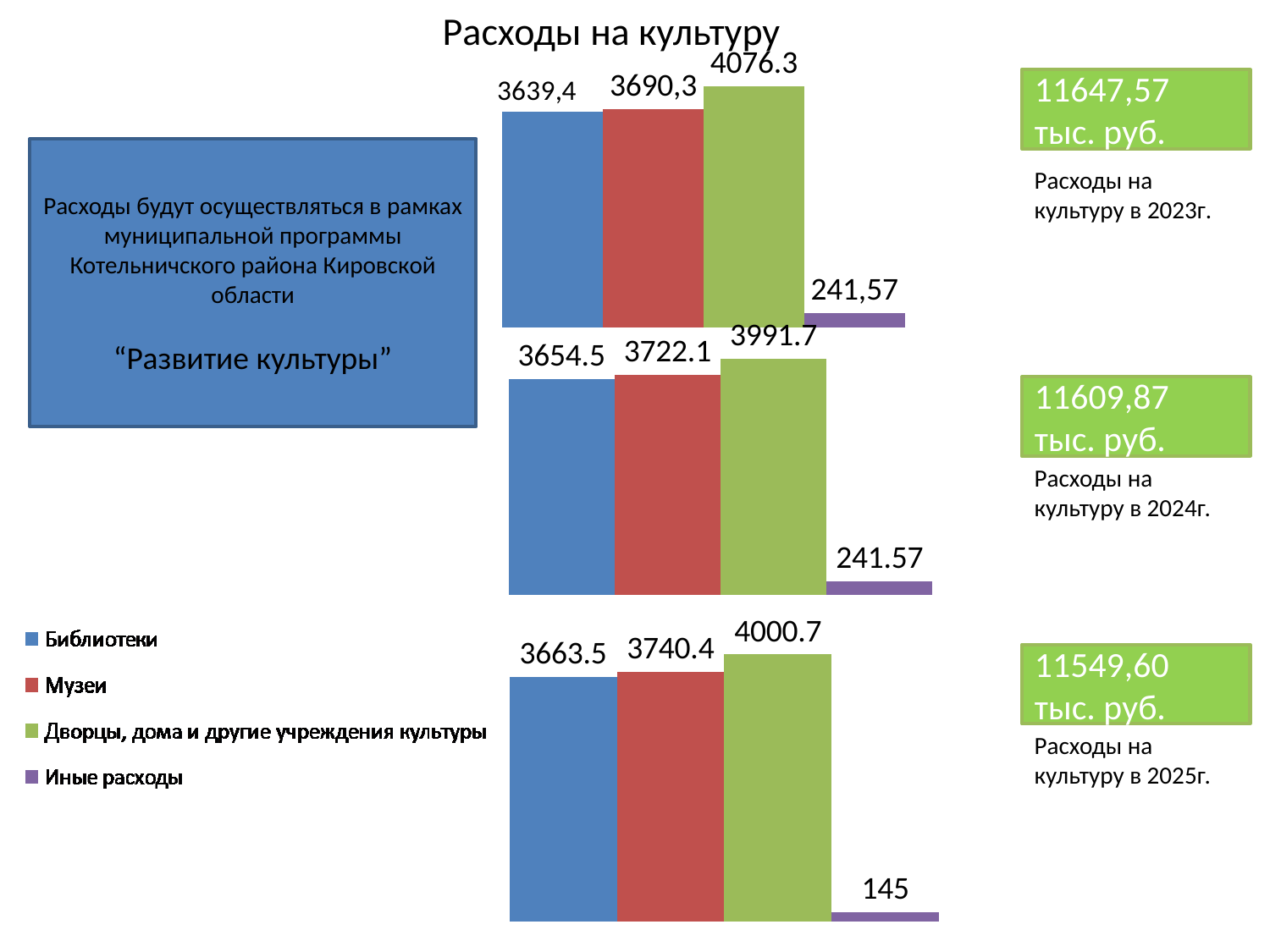
In the top chart (expenses for 2023), what is the value for Иные расходы? 241,57 In the middle chart (expenses for 2024), which category has the lowest value? Иные расходы How many series does the legend list? 4 In the top chart (expenses for 2023), which category has the highest value? Дворцы, дома и другие учреждения культуры In the bottom chart (expenses for 2025), what is the value for Иные расходы? 145 How many bars does the bottom chart (expenses for 2025) contain? 4 In the top chart (expenses for 2023), what is the value for Библиотеки? 3639,4 In the middle chart (expenses for 2024), what is the value for Музеи? 3722.1 In the bottom chart (expenses for 2025), which is larger: Библиотеки or Музеи? Музеи What type of chart is the top chart (expenses for 2023)? Bar chart In the middle chart (expenses for 2024), what is the difference between Дворцы, дома и другие учреждения культуры and Музеи? 269.6 In the bottom chart (expenses for 2025), what is the value for Дворцы, дома и другие учреждения культуры? 4000.7